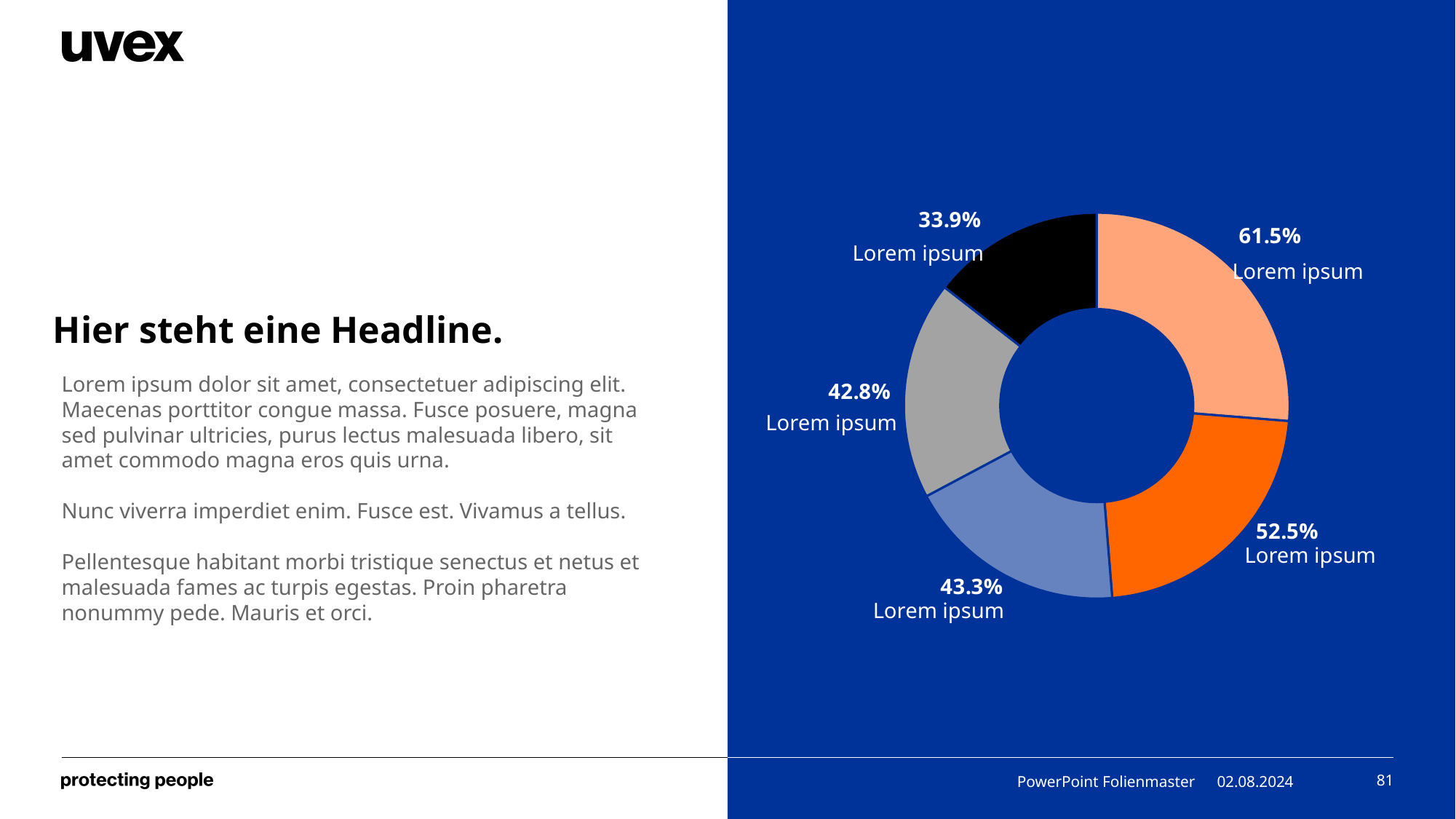
What category label is shown next to every slice of the doughnut chart? Lorem ipsum What value is labelled on the dark orange slice of the doughnut chart? 52.5% What value is labelled on the black slice of the doughnut chart? 33.9% What is the largest value shown on the doughnut chart? 61.5% What is the difference between the largest and smallest values on the doughnut chart? 27.6 percentage points What value is labelled on the light blue slice of the doughnut chart? 43.3% What value is labelled on the light orange (salmon) slice of the doughnut chart? 61.5% What value is labelled on the grey slice of the doughnut chart? 42.8% What is the smallest value shown on the doughnut chart? 33.9% Which slice has the larger value, the dark orange slice or the grey slice? The dark orange slice (52.5%) What kind of chart is shown on the slide? Doughnut (pie) chart How many slices does the doughnut chart have? 5